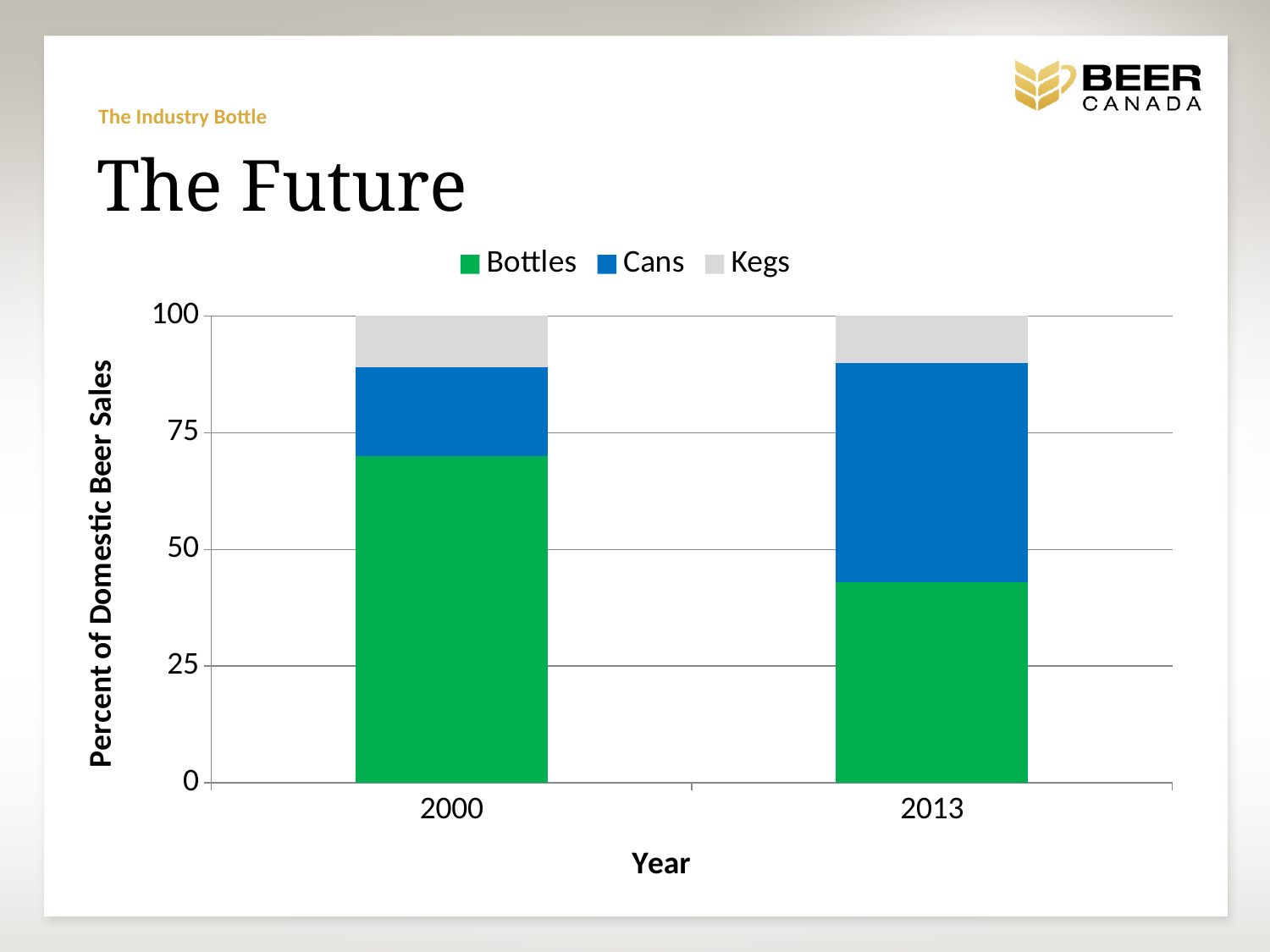
Which series has the smallest segment in the 2013 bar? Kegs Which year has the larger value for Bottles, 2000 or 2013? 2000 What is the label of the y axis? Percent of Domestic Beer Sales Is the value for Bottles in 2000 greater or less than 50? greater Is the value for Bottles in 2013 greater or less than 50? less How many series does the legend list? 3 What kind of chart is shown on the slide? Stacked bar chart How many years are shown on the x axis? 2 Which series are listed in the legend? Bottles, Cans, Kegs Does the share of Bottles rise or fall from 2000 to 2013? Fall Is the value for Cans in 2000 greater or less than 25? less Which year has the larger value for Cans, 2000 or 2013? 2013